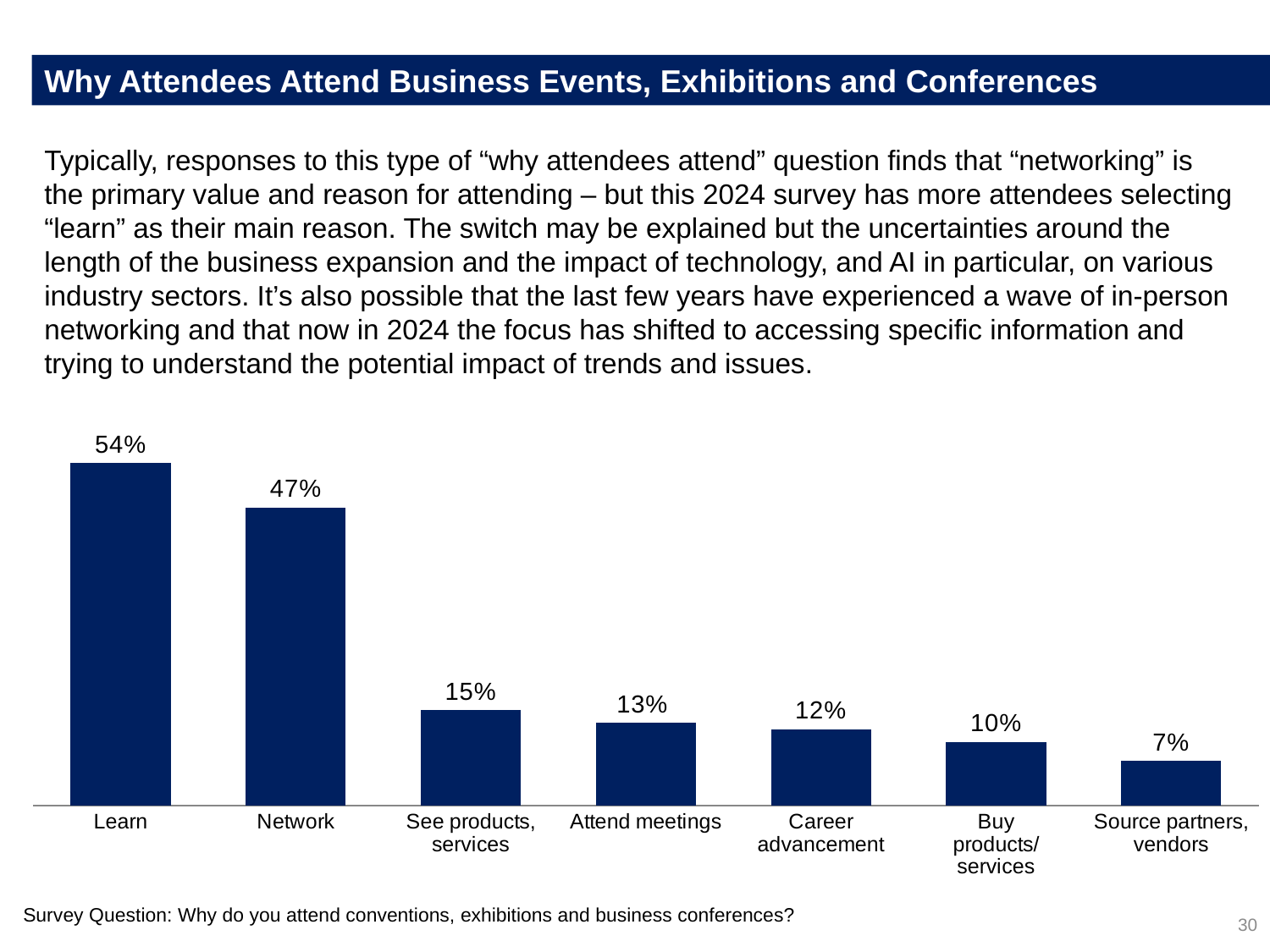
Which reason for attending has the highest percentage? Learn What is the value for "Source partners, vendors"? 7% What is the difference in percentage points between "See products, services" and "Buy products/services"? 5 Which reason for attending has the lowest percentage? Source partners, vendors Which has a higher value, "Attend meetings" or "Buy products/services"? Attend meetings What is the difference in percentage points between "Learn" and "Network"? 7 How many reasons for attending are shown in the chart? 7 What percentage of attendees selected "Learn" as their reason for attending? 54% What is the value shown for "Network"? 47% What percentage is shown for "Career advancement"? 12% What type of chart is shown on the slide? Bar chart Do the values rise or fall moving from left to right across the chart? Fall